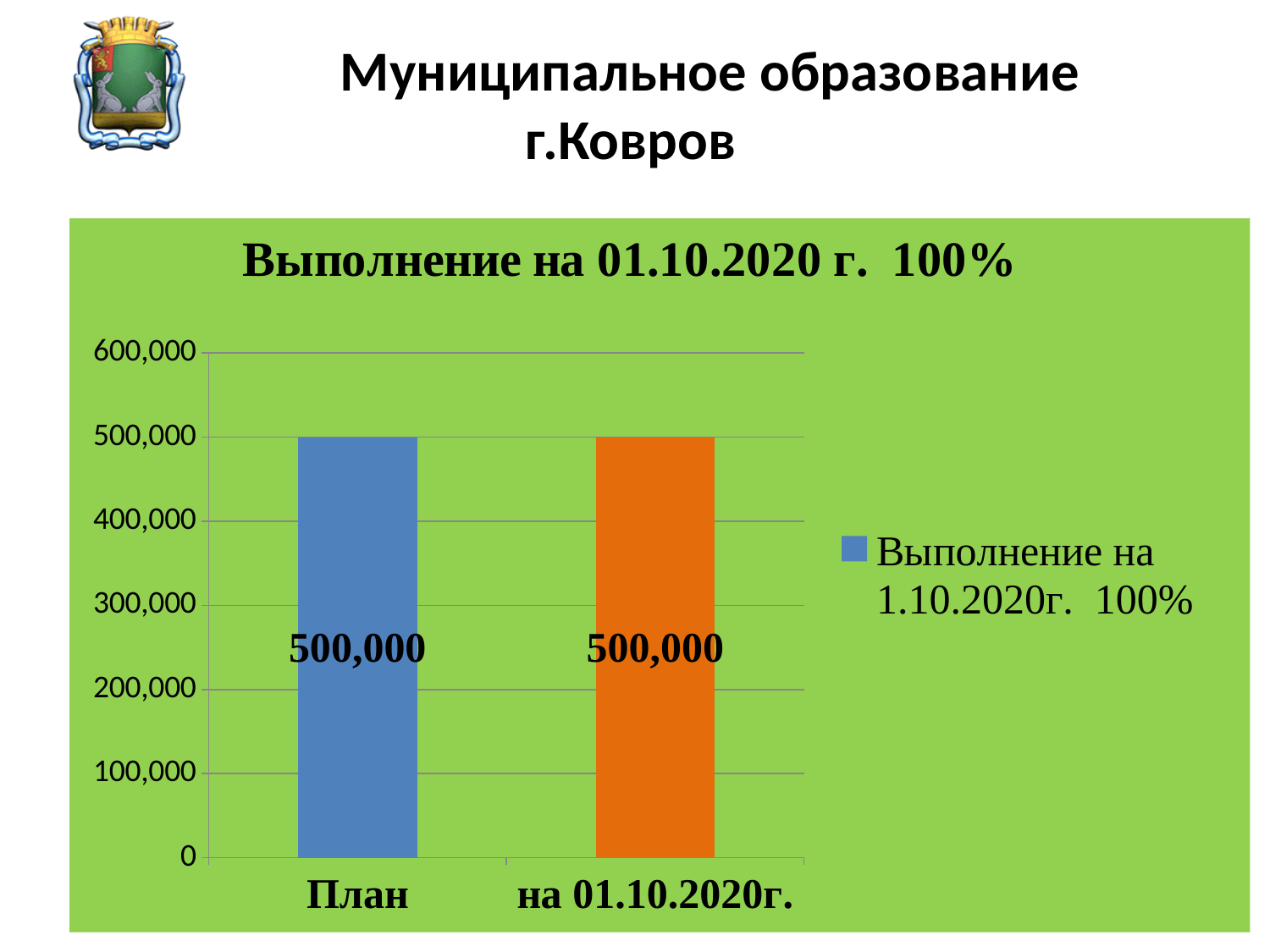
What is the highest value shown on the vertical axis? 600,000 Is the value for План greater or less than 400,000? greater Is the value for на 01.10.2020г. greater or less than 600,000? less How many series does the legend list? 1 What is the difference between the values for План and на 01.10.2020г.? 0 What is the title of the chart? Выполнение на 01.10.2020 г. 100% What is the value for на 01.10.2020г.? 500,000 What kind of chart is shown on the slide? bar chart What colour is the bar for на 01.10.2020г.? orange What is the value for План? 500,000 How many bars are shown in the chart? 2